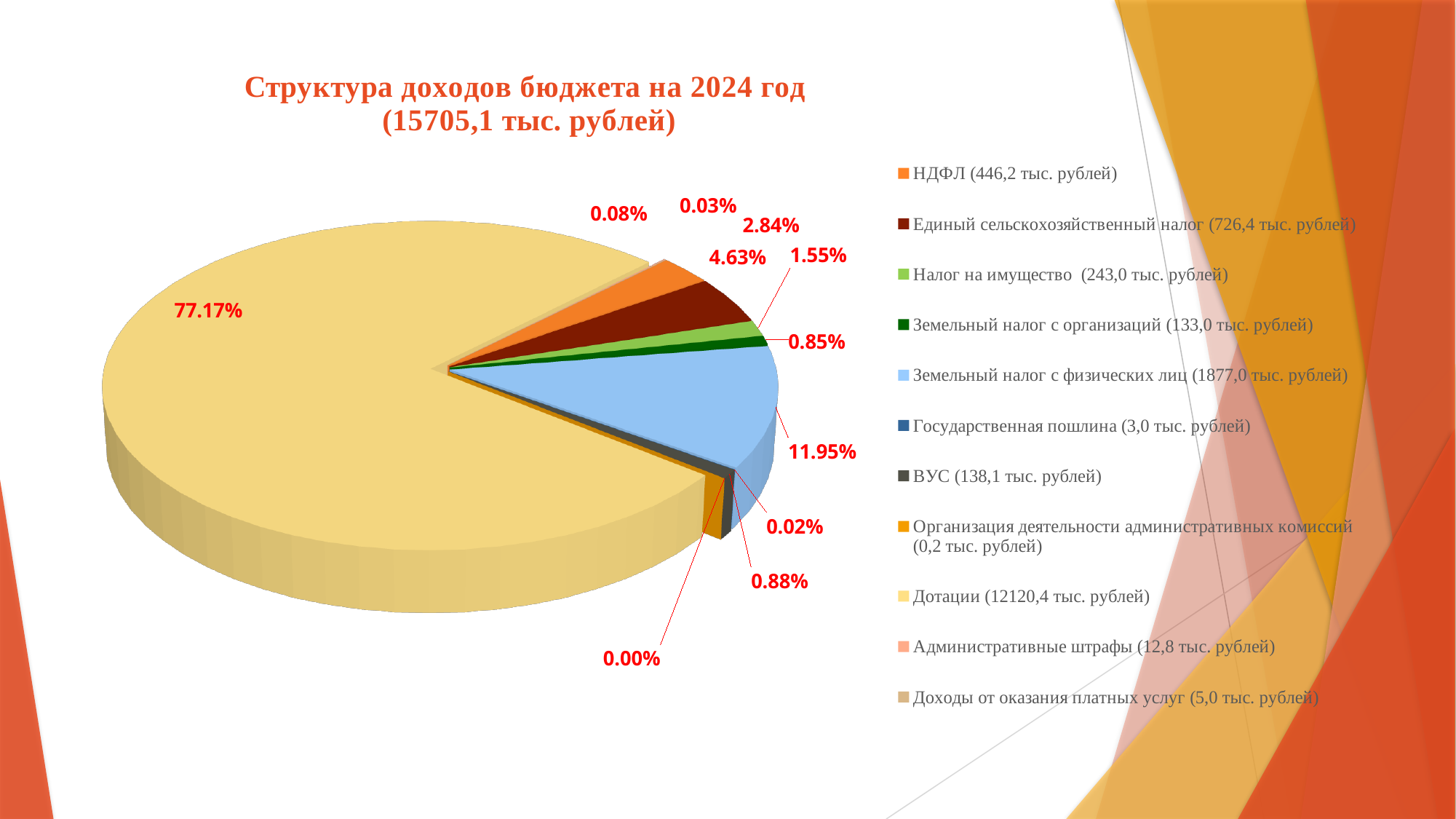
What share of the pie does Единый сельскохозяйственный налог account for? 4.63% What is the difference in percentage points between the share for Земельный налог с физических лиц and the share for Единый сельскохозяйственный налог? 7.32% Which category has the smallest share, shown as 0.00%? Организация деятельности административных комиссий Which category has the largest slice of the pie? Дотации What share of the pie does НДФЛ account for? 2.84% What kind of chart is shown on the slide? pie chart How many entries does the legend list? 11 Which is larger: the share for Налог на имущество or the share for Земельный налог с организаций? Налог на имущество What share of the pie does Земельный налог с физических лиц account for? 11.95% What is the title of the chart? Структура доходов бюджета на 2024 год (15705,1 тыс. рублей) According to the legend, what amount in тыс. рублей is given for ВУС? 138,1 тыс. рублей